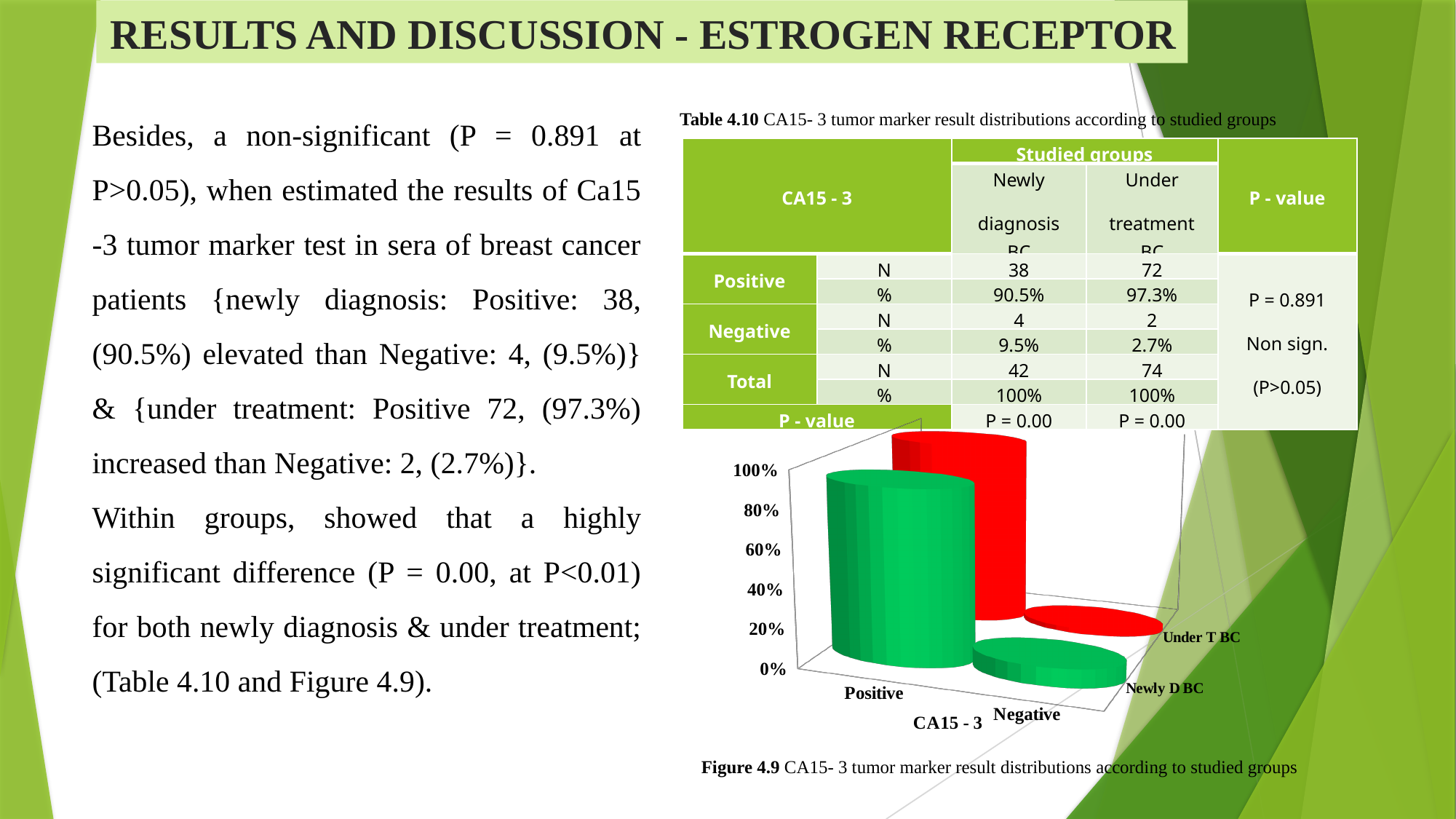
In the chart in Figure 4.9, is the value for Negative in the Newly D BC group greater or less than 20%? less In the chart in Figure 4.9, which category has the higher value for the Newly D BC group, Positive or Negative? Positive How many categories are shown on the x axis of the chart in Figure 4.9? 2 In the chart in Figure 4.9, is the value for Positive in the Newly D BC group greater or less than 80%? greater How many studied groups (series) are plotted in the chart in Figure 4.9? 2 What is the x-axis title of the chart in Figure 4.9? CA15 - 3 What kind of chart is shown in Figure 4.9? bar chart What colour are the bars for the Newly D BC group in the chart in Figure 4.9? green In the chart in Figure 4.9, is the value for Positive in the Under T BC group greater or less than 80%? greater In the chart in Figure 4.9, which category has the lowest value for the Under T BC group? Negative In the chart in Figure 4.9, which category has the highest value across both groups? Positive